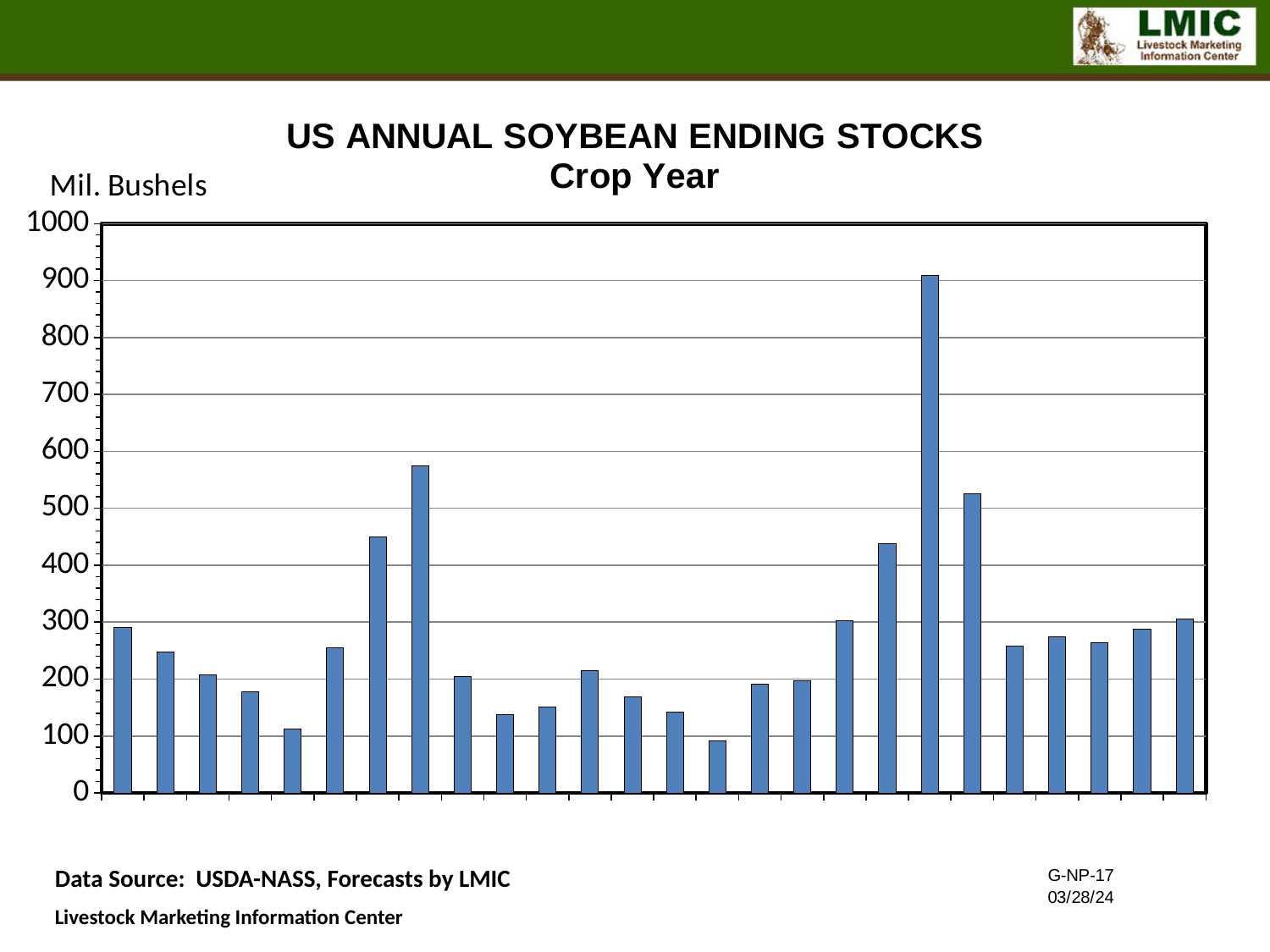
Is the value of the tallest bar greater or less than 800? greater Is the second bar from the left taller or shorter than the fifth bar from the left? taller What kind of chart is shown on the slide? bar chart What is the title of the chart? US ANNUAL SOYBEAN ENDING STOCKS Is the value of the seventh bar from the left greater or less than 400? greater Is the value of the first bar from the left greater or less than 400? less How many bars are plotted in the chart? 26 Is the tallest bar in the chart taller or shorter than the bar immediately to its right? taller What unit is shown on the vertical axis of the chart? Mil. Bushels